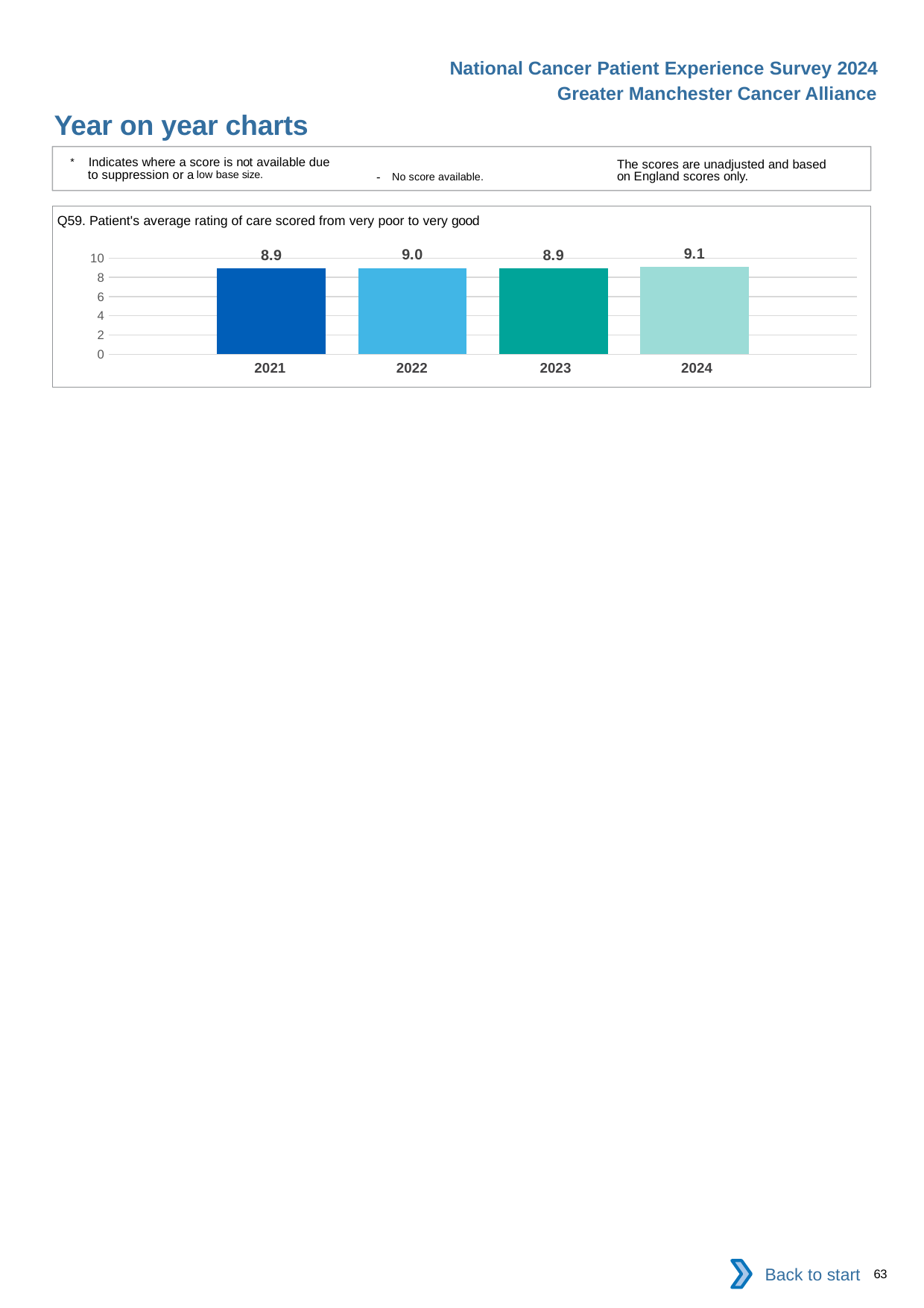
What is the value for 2024? 9.1 How many years are shown on the chart? 4 What is the title of the chart? Q59. Patient's average rating of care scored from very poor to very good Is the value for 2023 greater or less than 8? greater What kind of chart is shown on the slide? Bar chart What is the value for 2021? 8.9 What is the difference between the values for 2022 and 2023? 0.1 What is the value for 2023? 8.9 Which is larger, the value for 2024 or the value for 2022? 2024 Which year has the highest value? 2024 What is the value for 2022? 9.0 What is the difference between the values for 2024 and 2021? 0.2